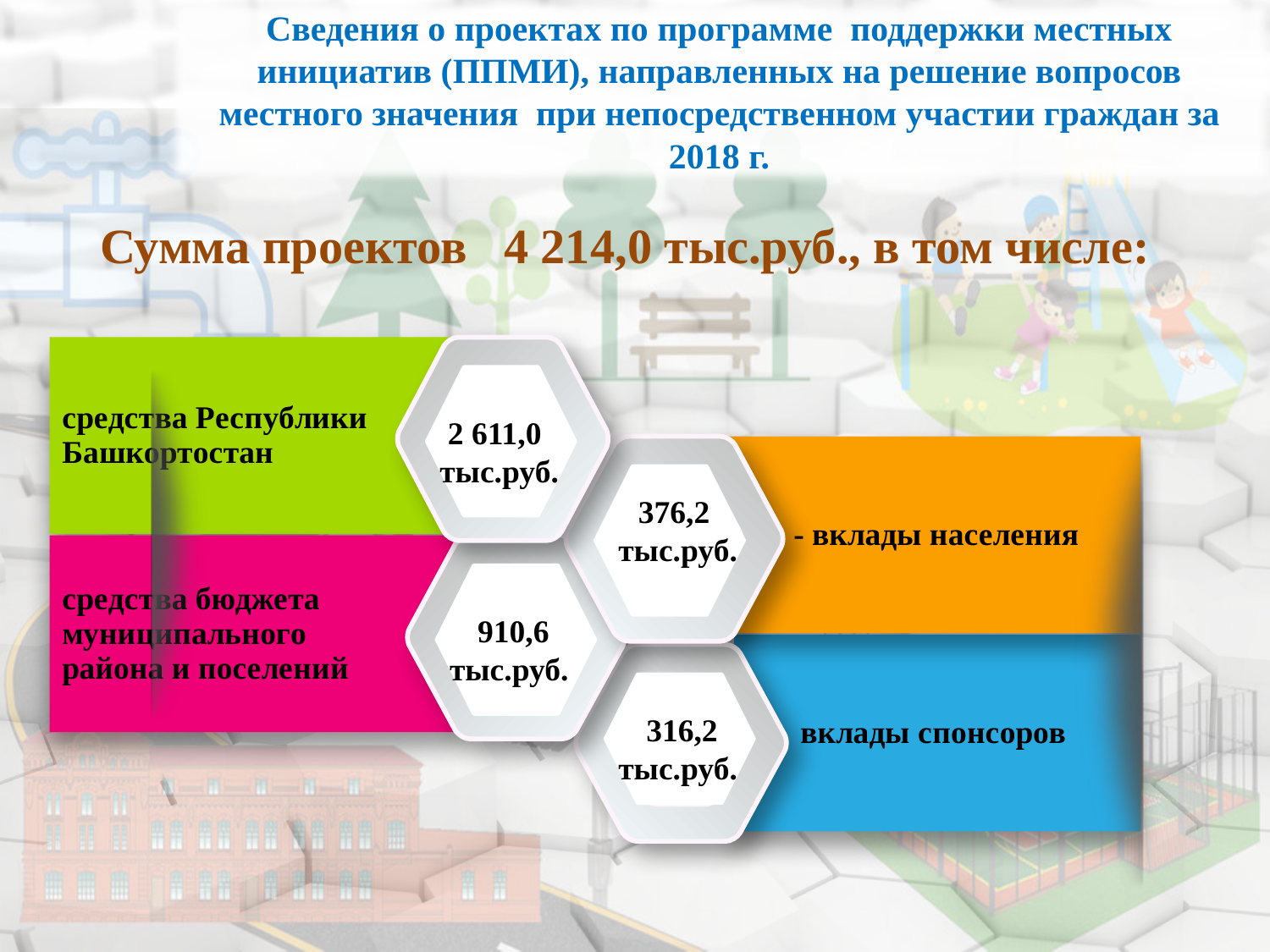
What amount is shown for вклады спонсоров? 316,2 тыс.руб. What is the difference between вклады населения and вклады спонсоров? 60,0 тыс.руб. How many funding sources are shown in the diagram? 4 What colour is the block for вклады спонсоров? Blue What amount is shown for вклады населения? 376,2 тыс.руб. What is the difference between средства Республики Башкортостан and средства бюджета муниципального района и поселений? 1 700,4 тыс.руб. What is the total sum of projects shown on the slide? 4 214,0 тыс.руб. Which funding source has the smallest amount? вклады спонсоров What amount is shown for средства бюджета муниципального района и поселений? 910,6 тыс.руб. What amount is shown for средства Республики Башкортостан? 2 611,0 тыс.руб. Which is larger: вклады населения or вклады спонсоров? вклады населения Which funding source has the largest amount? средства Республики Башкортостан